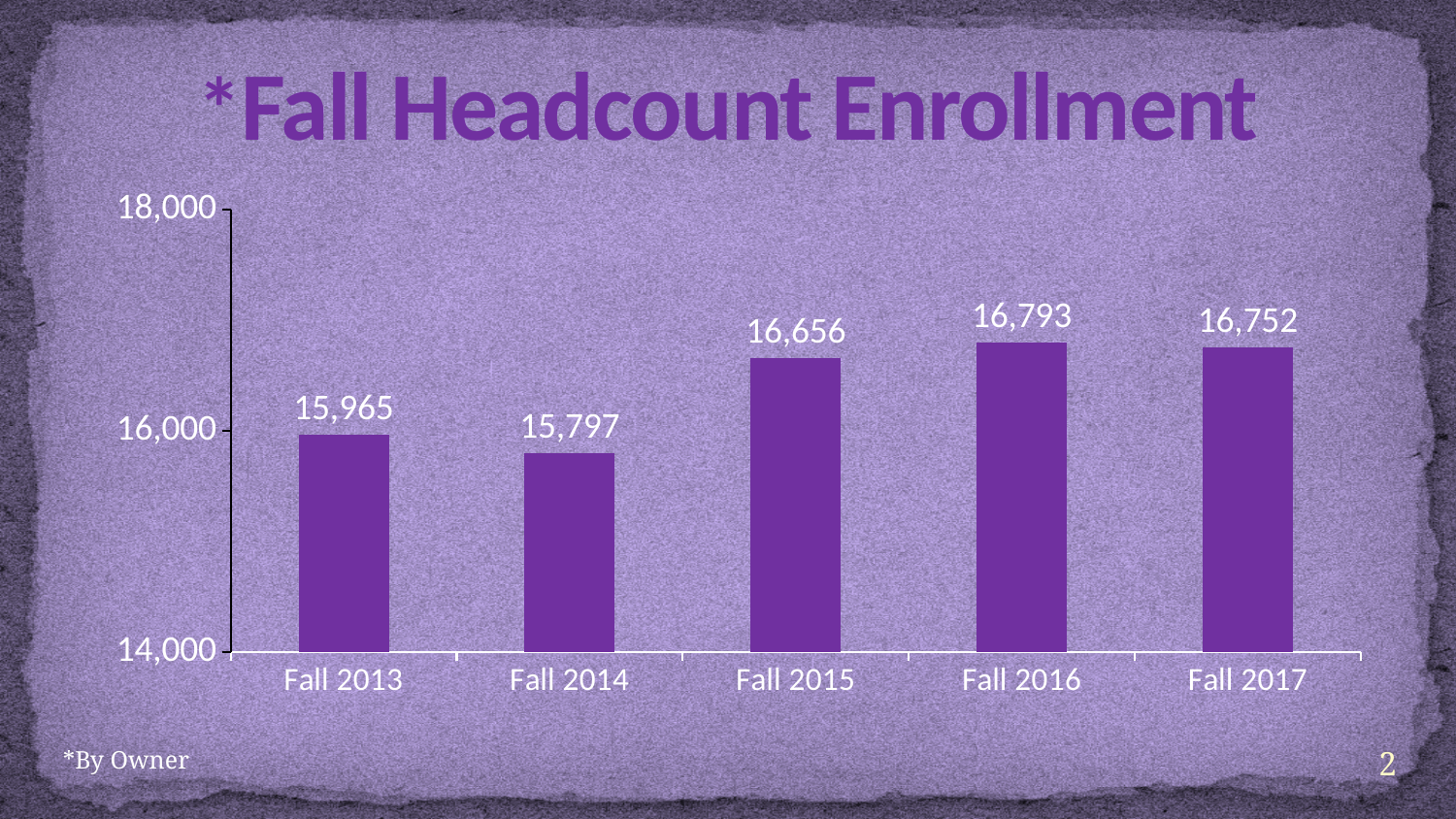
How many fall terms are shown on the chart? 5 What is the difference in headcount enrollment between Fall 2016 and Fall 2014? 996 What is the fall headcount enrollment for Fall 2013? 15,965 What is the title of the chart? *Fall Headcount Enrollment Which fall term has the lowest headcount enrollment? Fall 2014 What is the fall headcount enrollment for Fall 2015? 16,656 What is the difference in headcount enrollment between Fall 2015 and Fall 2013? 691 Which is larger, the enrollment for Fall 2013 or Fall 2014? Fall 2013 What kind of chart is shown on the slide? Bar chart Is the enrollment for Fall 2014 greater or less than 16,000? less Which fall term has the highest headcount enrollment? Fall 2016 What is the fall headcount enrollment for Fall 2017? 16,752